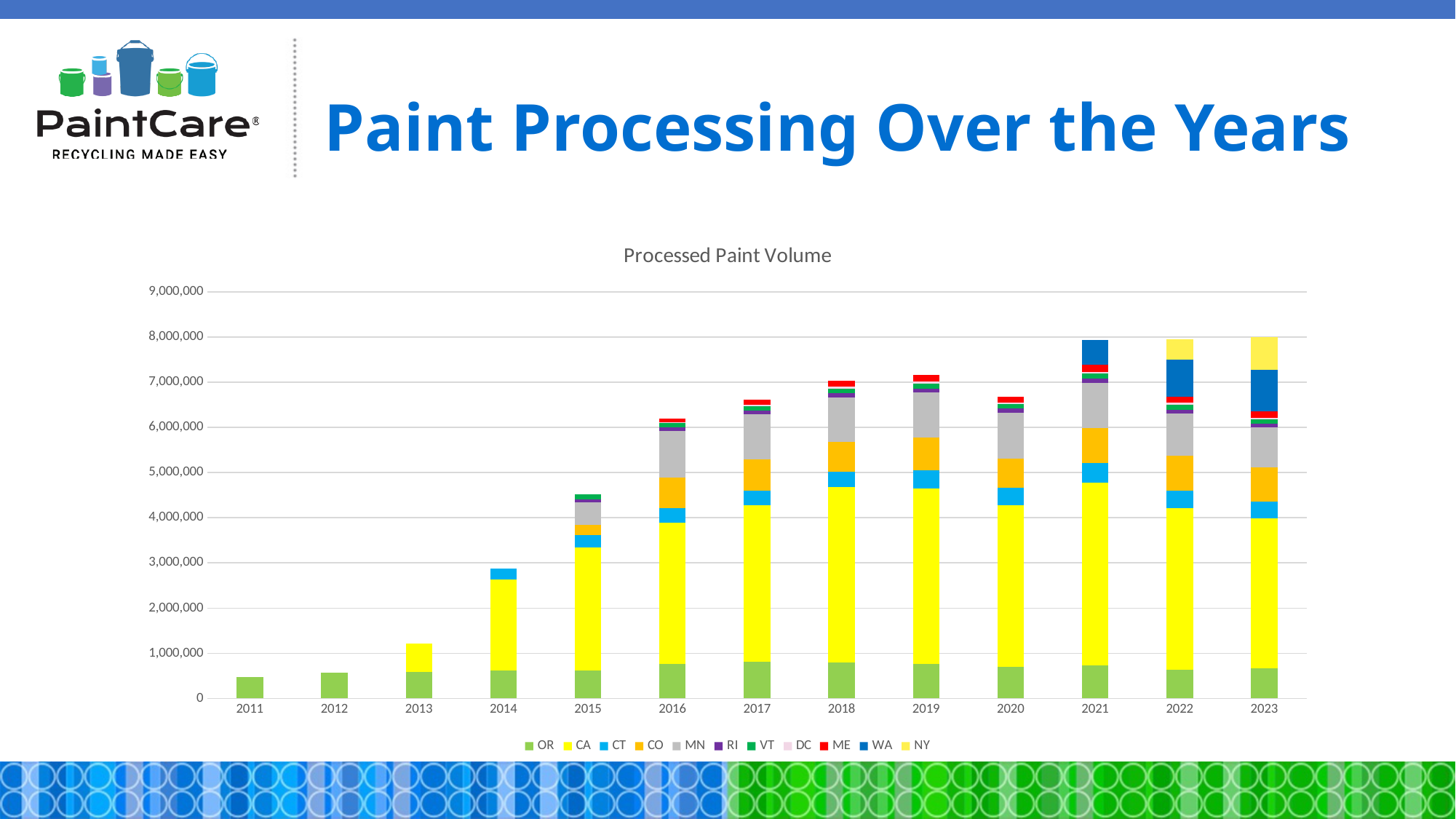
Is the total processed paint volume for 2016 greater or less than 6,000,000? greater What is the title of the chart? Processed Paint Volume Is the total processed paint volume for 2013 greater or less than 1,000,000? greater Which year has the lowest total processed paint volume? 2011 Is the total processed paint volume for 2014 greater or less than 3,000,000? less Which year has the larger total processed paint volume, 2019 or 2020? 2019 What type of chart is shown on the slide? Stacked bar chart Does the total processed paint volume rise or fall from 2011 to 2016? rise Which state is the only series with a segment in the 2011 bar? OR How many years are shown along the x axis of the chart? 13 How many series does the chart legend list? 11